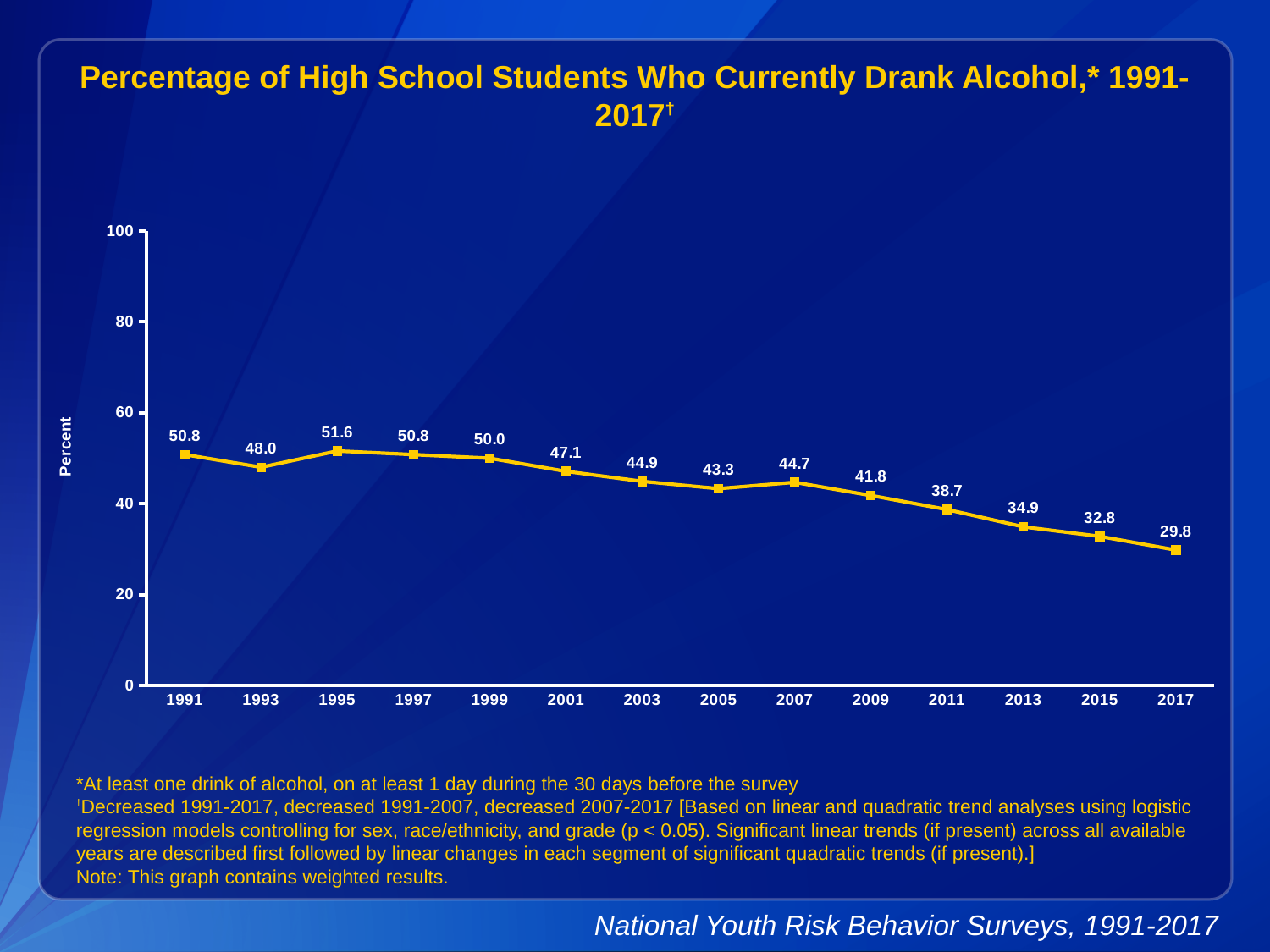
What value is shown for 2009? 41.8 What kind of chart is shown on the slide? line chart What is the label on the y axis? Percent Which year has a larger value, 2005 or 2007? 2007 Which year has the lowest percentage? 2017 Which year has the highest percentage? 1995 What was the percentage of high school students who currently drank alcohol in 1991? 50.8 What is the difference between the values for 1991 and 2017? 21.0 Do the values generally rise or fall from 1991 to 2017? fall Is the value for 2013 greater or less than 40? less What was the percentage of high school students who currently drank alcohol in 2017? 29.8 How many years are plotted on the x axis? 14